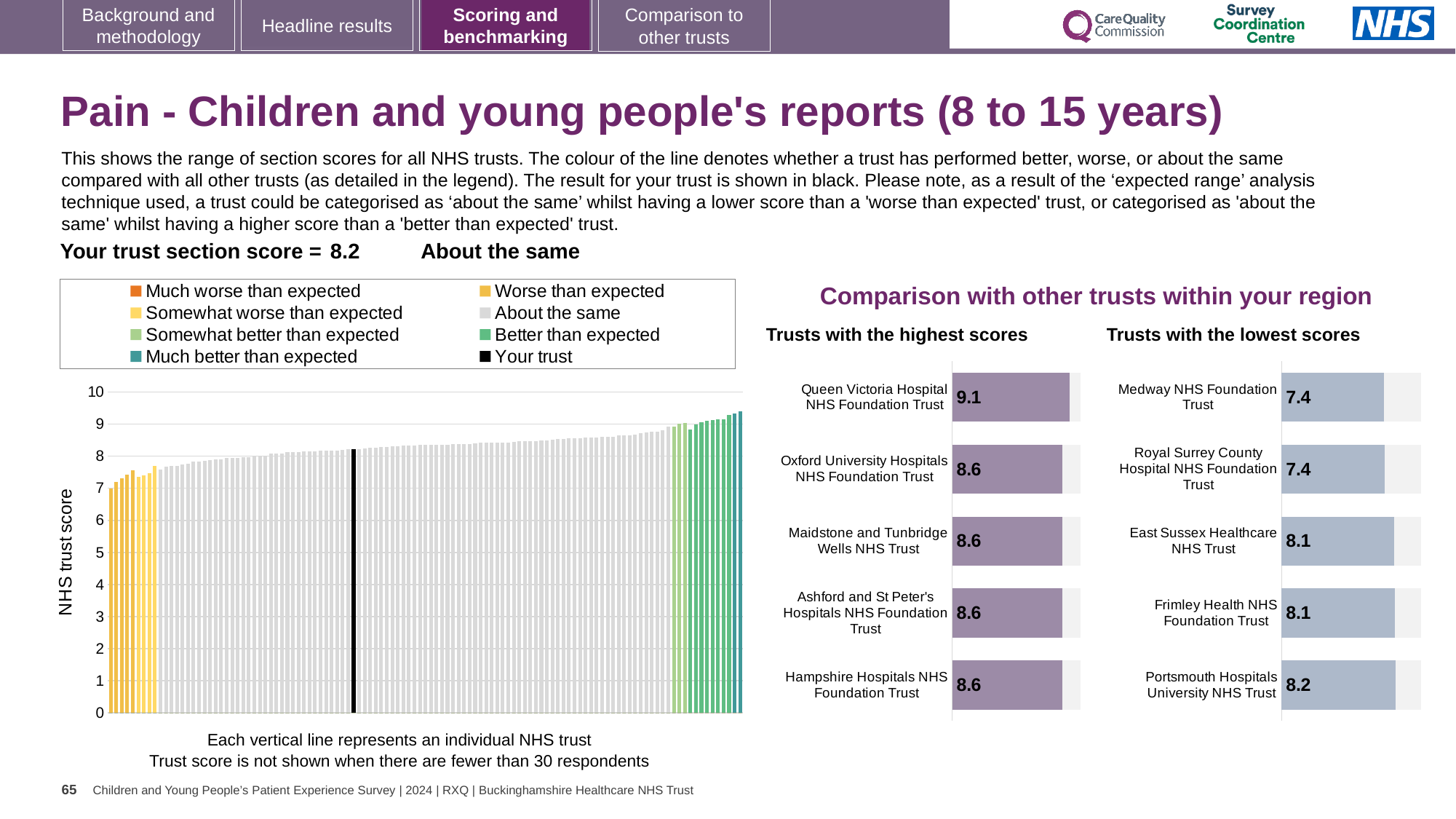
In the 'Trusts with the highest scores' chart, which trust has the highest score? Queen Victoria Hospital NHS Foundation Trust In the 'Trusts with the highest scores' chart, what is the difference between the scores of Queen Victoria Hospital NHS Foundation Trust and Oxford University Hospitals NHS Foundation Trust? 0.5 In the 'Trusts with the lowest scores' chart, what is the score for Medway NHS Foundation Trust? 7.4 How many trusts are shown in the 'Trusts with the highest scores' chart? 5 In the 'Trusts with the lowest scores' chart, what is the score for Portsmouth Hospitals University NHS Trust? 8.2 In the 'Trusts with the lowest scores' chart, which has the larger score: East Sussex Healthcare NHS Trust or Medway NHS Foundation Trust? East Sussex Healthcare NHS Trust How many entries does the legend of the NHS trust score chart on the left list? 8 What kind of chart is the NHS trust score chart on the left of the slide? Bar chart In the NHS trust score chart on the left, what is the section score for your trust (the black bar)? 8.2 In the 'Trusts with the highest scores' chart, what is the score for Queen Victoria Hospital NHS Foundation Trust? 9.1 In the NHS trust score chart on the left, do the values rise or fall from left to right? Rise In the 'Trusts with the lowest scores' chart, what is the difference between the scores of Portsmouth Hospitals University NHS Trust and Medway NHS Foundation Trust? 0.8